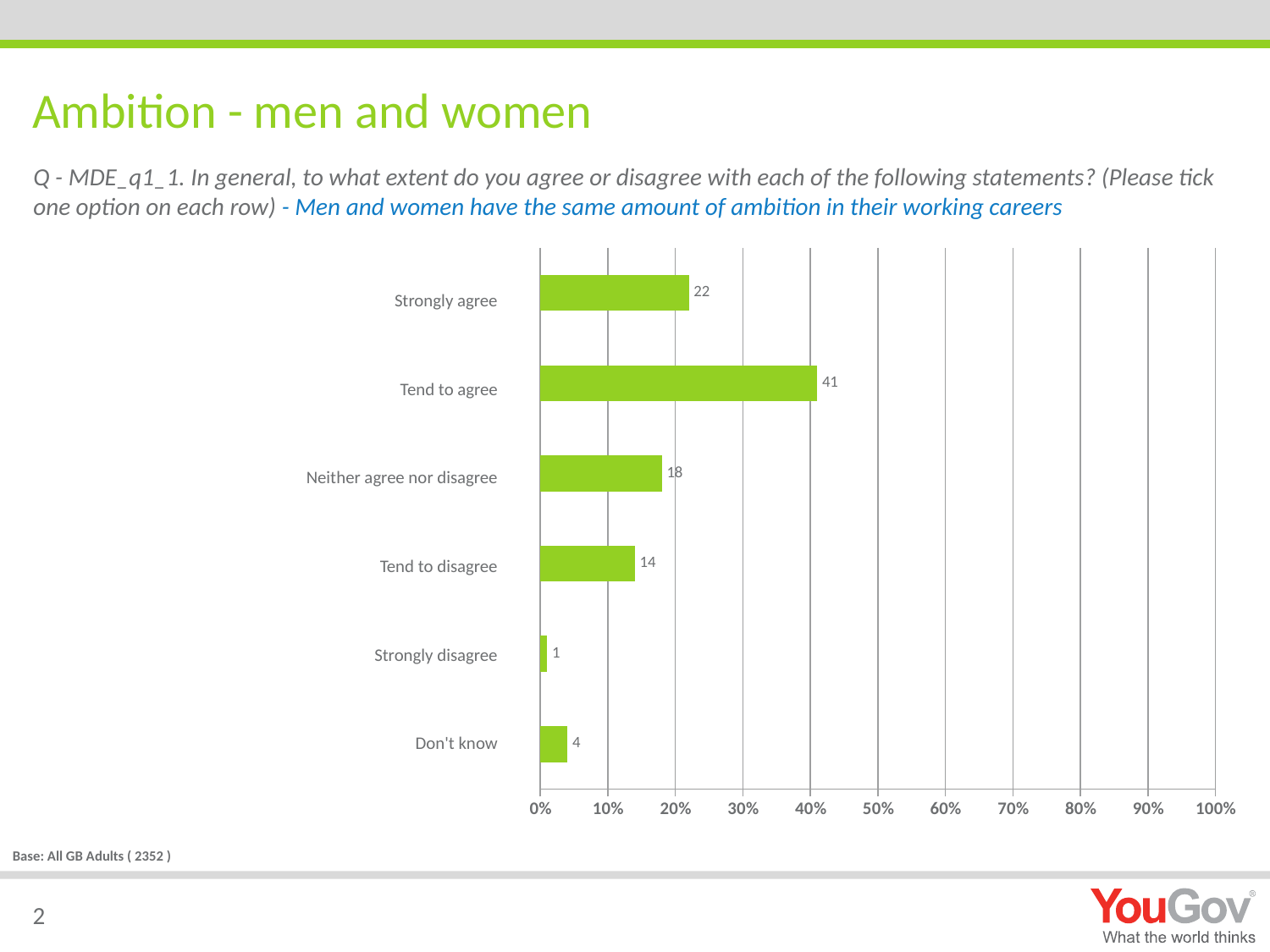
What kind of chart is shown on the slide? Bar chart Which category has the lowest value? Strongly disagree Is the value for "Tend to agree" greater or less than 30%? greater What is the value for "Don't know"? 4 What is the value for "Neither agree nor disagree"? 18 Which is larger, the value for "Neither agree nor disagree" or the value for "Tend to disagree"? Neither agree nor disagree What is the value for "Tend to agree"? 41 What is the difference between the values for "Tend to agree" and "Strongly agree"? 19 What is the value for "Strongly agree"? 22 What is the title of the slide? Ambition - men and women Which category has the highest value? Tend to agree How many categories are shown on the chart? 6